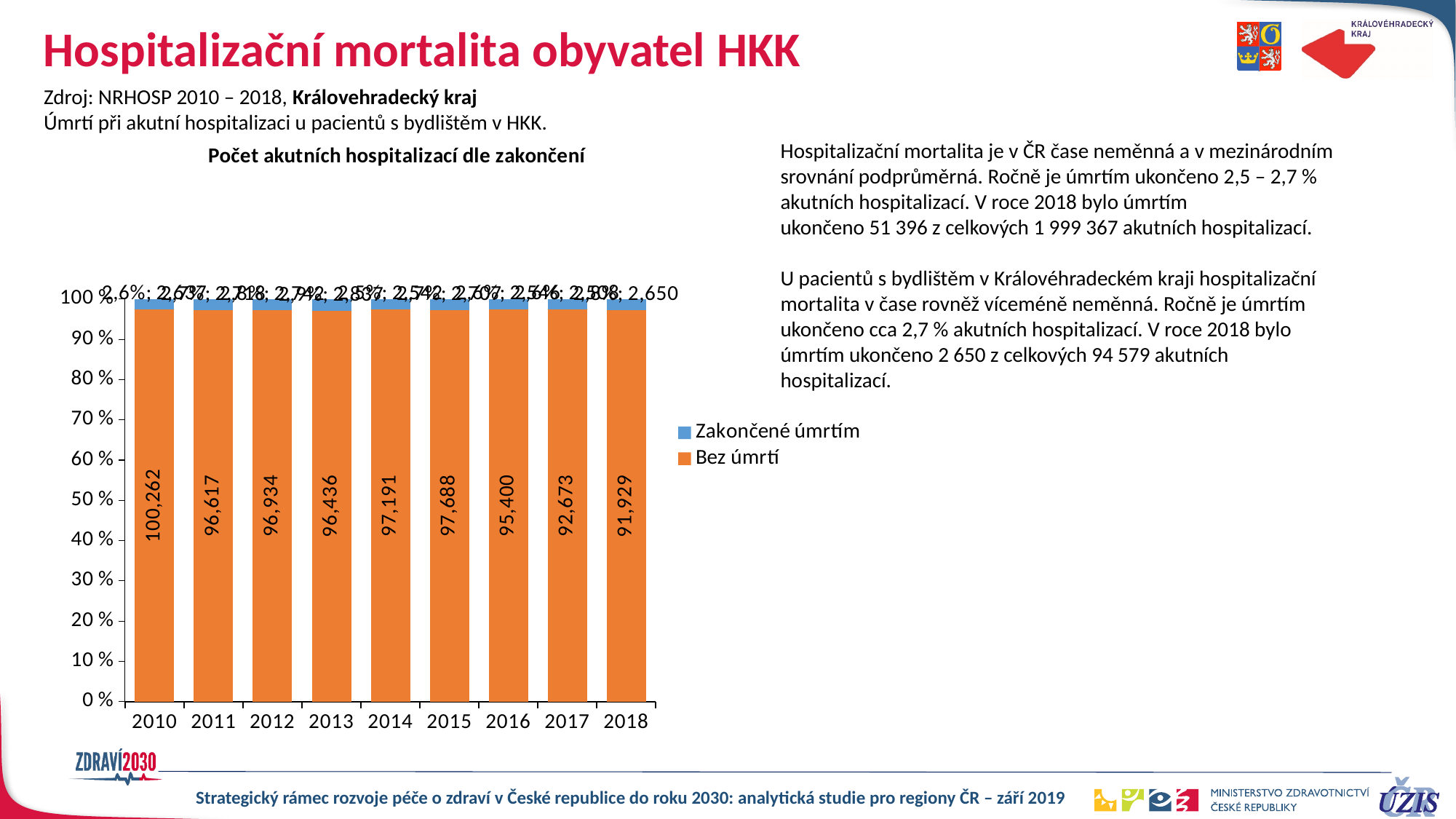
How many series does the chart legend list? 2 What kind of chart is shown on the slide? Stacked bar chart What is the value of the 'Bez úmrtí' series for 2016? 95,400 How many years are shown on the x axis of the chart? 9 In which year is the 'Bez úmrtí' value the lowest? 2018 What is the difference between the 'Bez úmrtí' values for 2010 and 2018? 8,333 In which year is the 'Bez úmrtí' value the highest? 2010 What is the title of the chart? Počet akutních hospitalizací dle zakončení Which year has the larger 'Bez úmrtí' value, 2014 or 2015? 2015 What is the value of the 'Bez úmrtí' series for 2010? 100,262 What is the value of the 'Bez úmrtí' series for 2018? 91,929 What is the difference between the 'Bez úmrtí' values for 2016 and 2017? 2,727